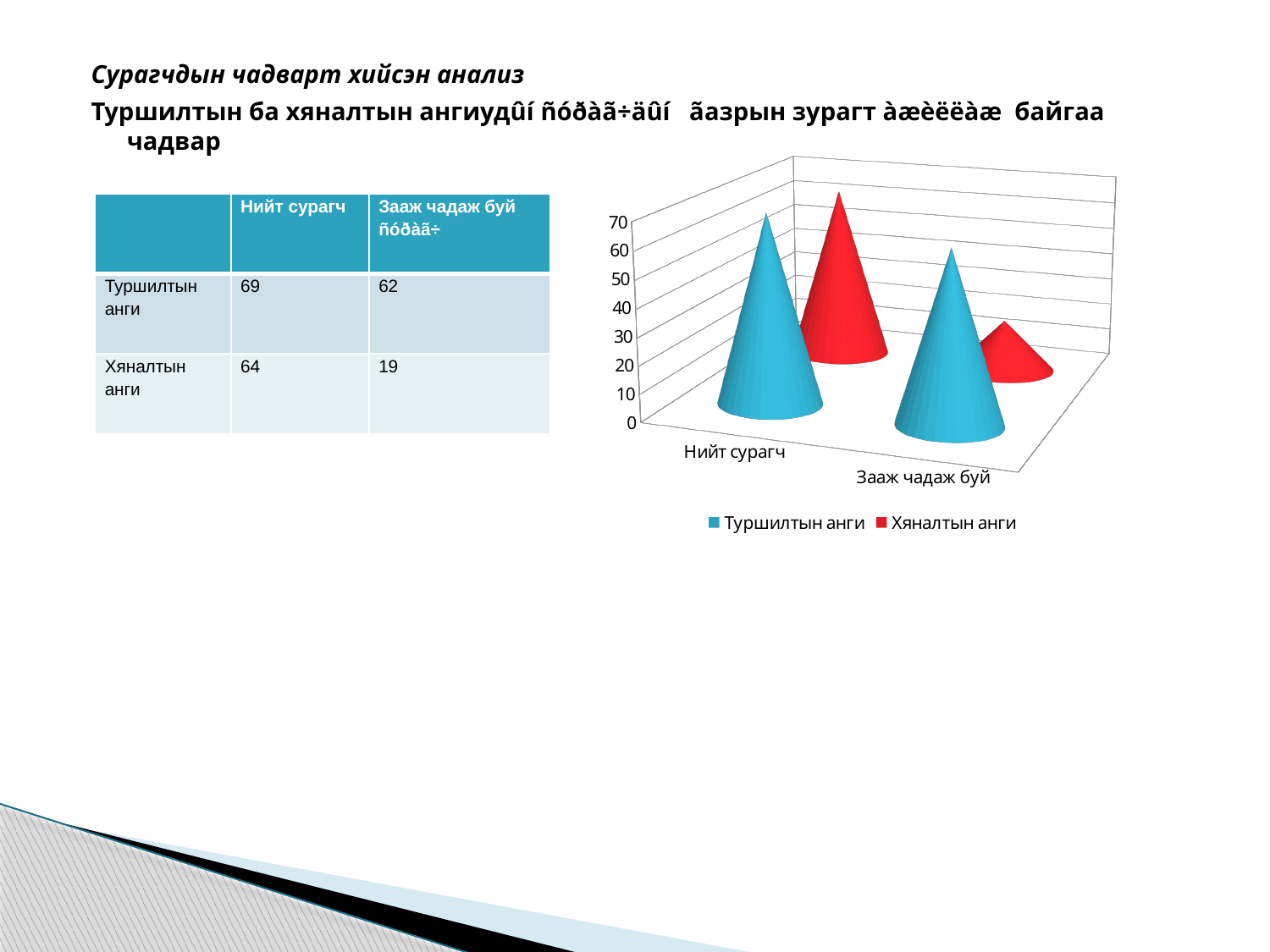
What is the value for Хяналтын анги in the Зааж чадаж буй category? 19 Which series and category combination has the lowest value in the chart? Хяналтын анги, Зааж чадаж буй How many series does the chart legend list? 2 What colour represents Хяналтын анги in the chart legend? red Is the value for Туршилтын анги in the Нийт сурагч category greater or less than 60? greater Is the value for Хяналтын анги in the Зааж чадаж буй category greater or less than 30? less In the Зааж чадаж буй category, which series has the larger value, Туршилтын анги or Хяналтын анги? Туршилтын анги What is the value for Туршилтын анги in the Нийт сурагч category? 69 What kind of chart is shown on the slide? bar chart How many categories are shown on the x axis of the chart? 2 Does the value for Хяналтын анги rise or fall from Нийт сурагч to Зааж чадаж буй? fall What is the difference between Туршилтын анги and Хяналтын анги in the Зааж чадаж буй category? 43